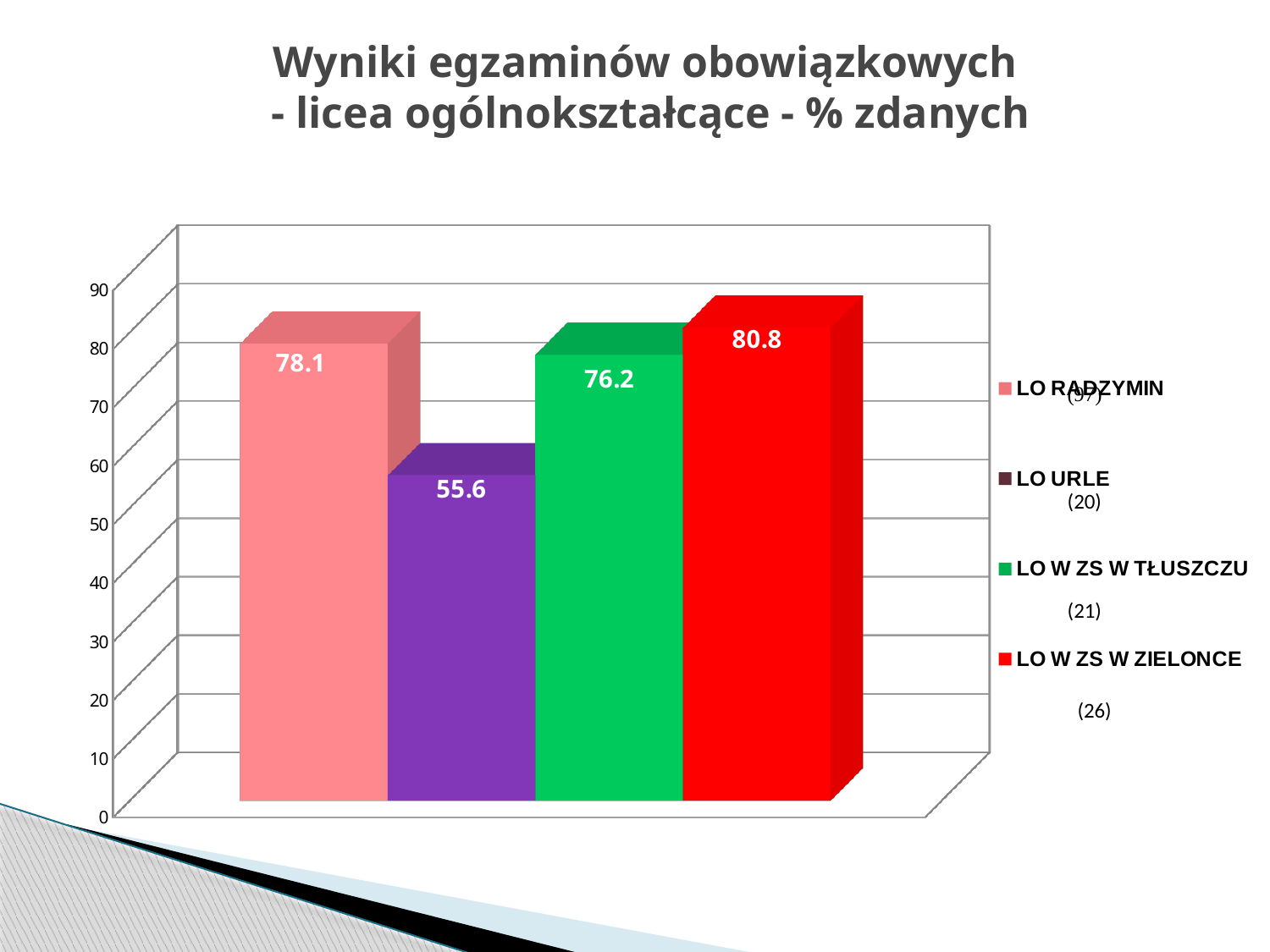
What colour is the bar for LO W ZS W TŁUSZCZU? green What is the value shown for LO RADZYMIN? 78.1 What is the difference between the values for LO RADZYMIN and LO W ZS W TŁUSZCZU? 1.9 Which school has the lowest value on the chart? LO URLE What kind of chart is shown on the slide? bar chart How many series does the legend list? 4 What is the value shown for LO W ZS W ZIELONCE? 80.8 Which is larger, the value for LO RADZYMIN or the value for LO URLE? LO RADZYMIN Which school has the highest value on the chart? LO W ZS W ZIELONCE What is the value shown for LO URLE? 55.6 What is the value shown for LO W ZS W TŁUSZCZU? 76.2 What is the difference between the values for LO W ZS W ZIELONCE and LO URLE? 25.2